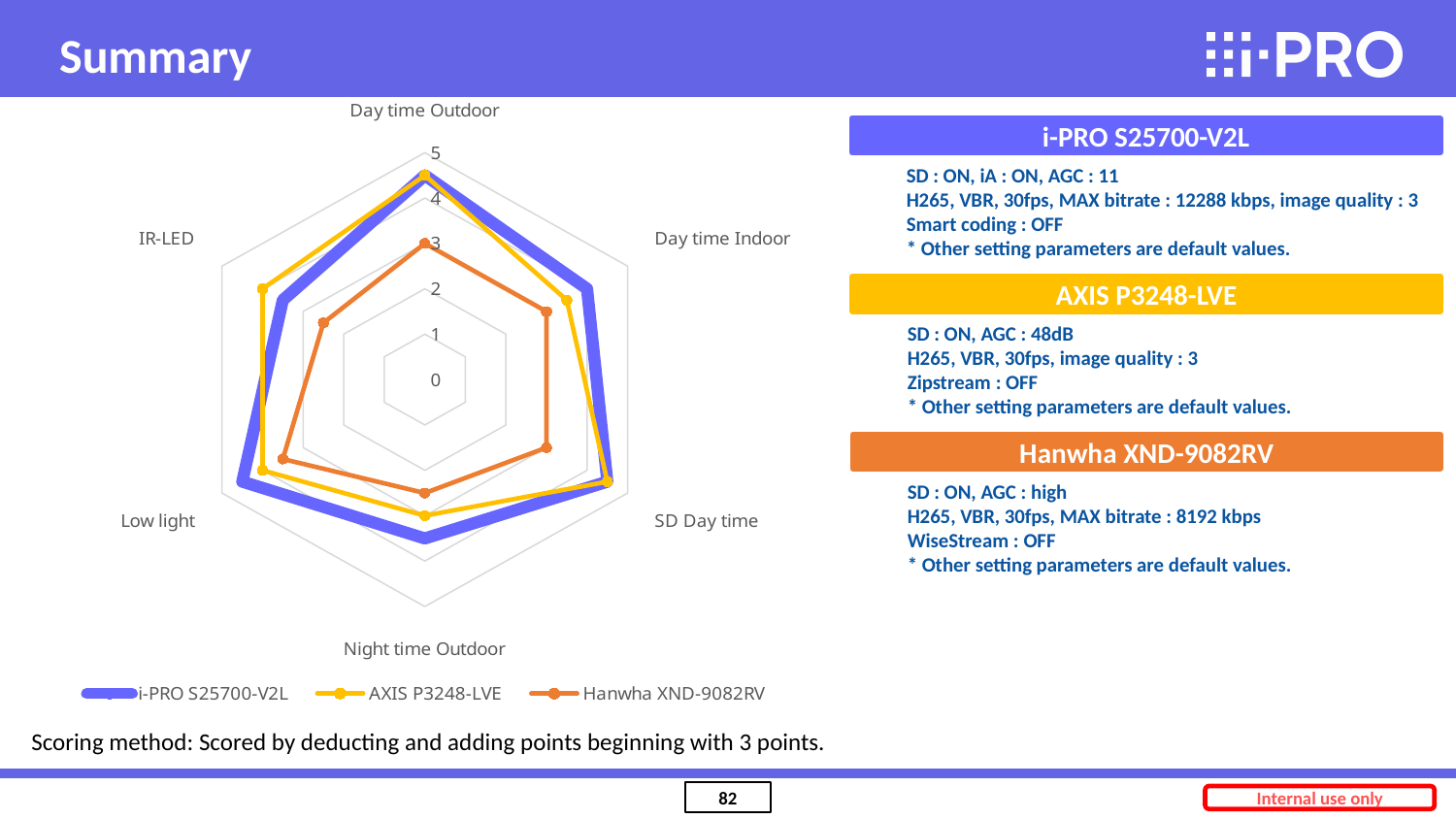
Is the value for i-PRO S25700-V2L on Day time Outdoor greater or less than 4? greater On the Day time Indoor axis, which has the larger value: i-PRO S25700-V2L or Hanwha XND-9082RV? i-PRO S25700-V2L How many categories (axes) does the radar chart have? 6 Is the value for Hanwha XND-9082RV on Day time Outdoor greater or less than 4? less Is the value for i-PRO S25700-V2L on Low light greater or less than 4? greater Which series has the lowest value on the Day time Outdoor axis? Hanwha XND-9082RV On the IR-LED axis, which has the larger value: AXIS P3248-LVE or Hanwha XND-9082RV? AXIS P3248-LVE Which series is drawn in blue on the radar chart? i-PRO S25700-V2L What kind of chart is shown on the slide? Radar chart What is the maximum value shown on the radar chart's scale? 5 How many series does the chart legend list? 3